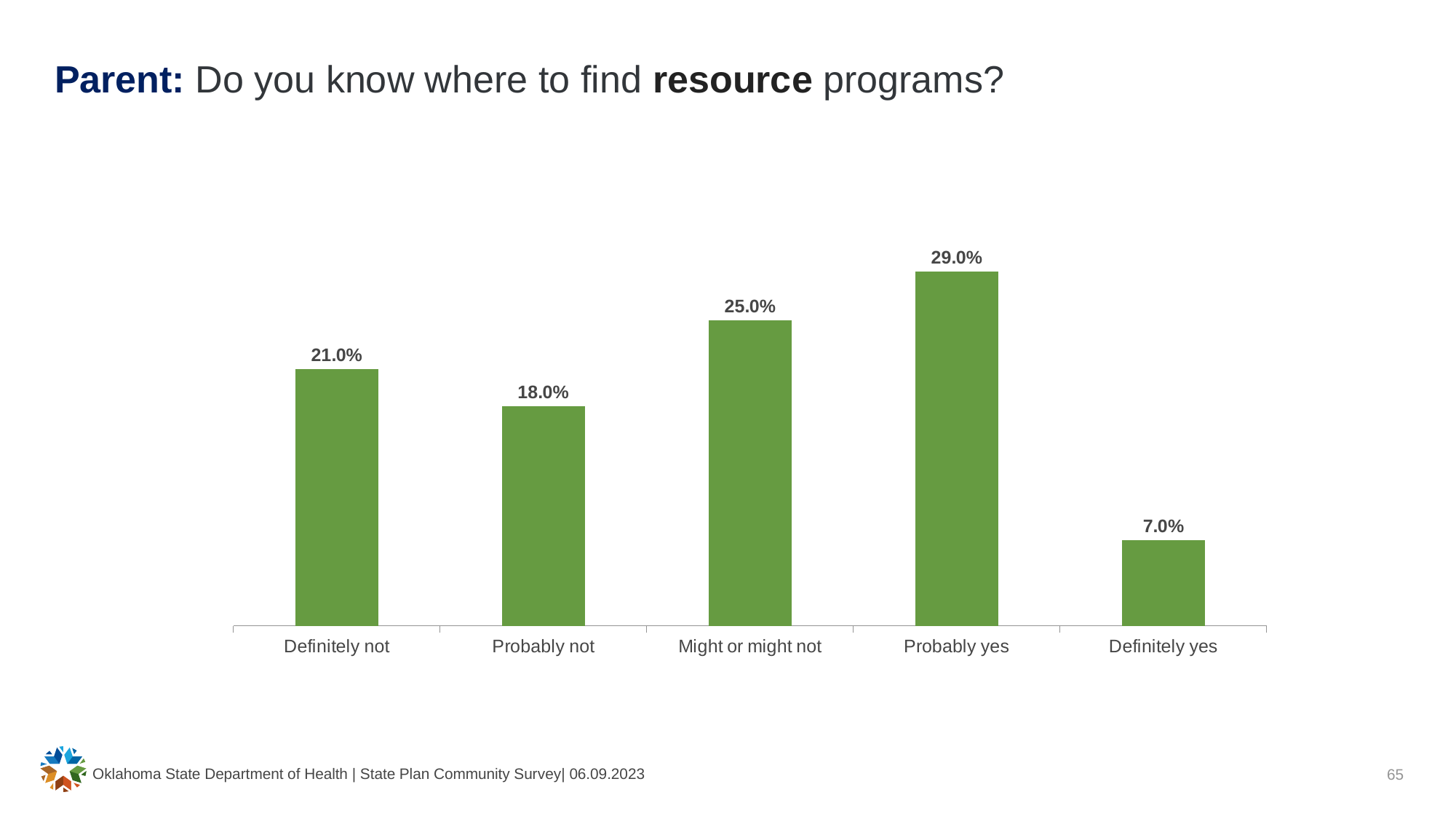
What kind of chart is shown on the slide? Bar chart Which response category has the lowest value? Definitely yes What is the value for "Might or might not"? 25.0% What is the difference between the values for "Definitely not" and "Probably not"? 3.0% What is the value for "Probably not"? 18.0% What percentage of parents answered "Definitely not"? 21.0% Which is larger, the value for "Might or might not" or the value for "Definitely not"? Might or might not What is the difference between the values for "Probably yes" and "Definitely yes"? 22.0% What colour are the bars in the chart? Green How many response categories are shown on the chart? 5 Which response category has the highest value? Probably yes What percentage of parents answered "Definitely yes"? 7.0%